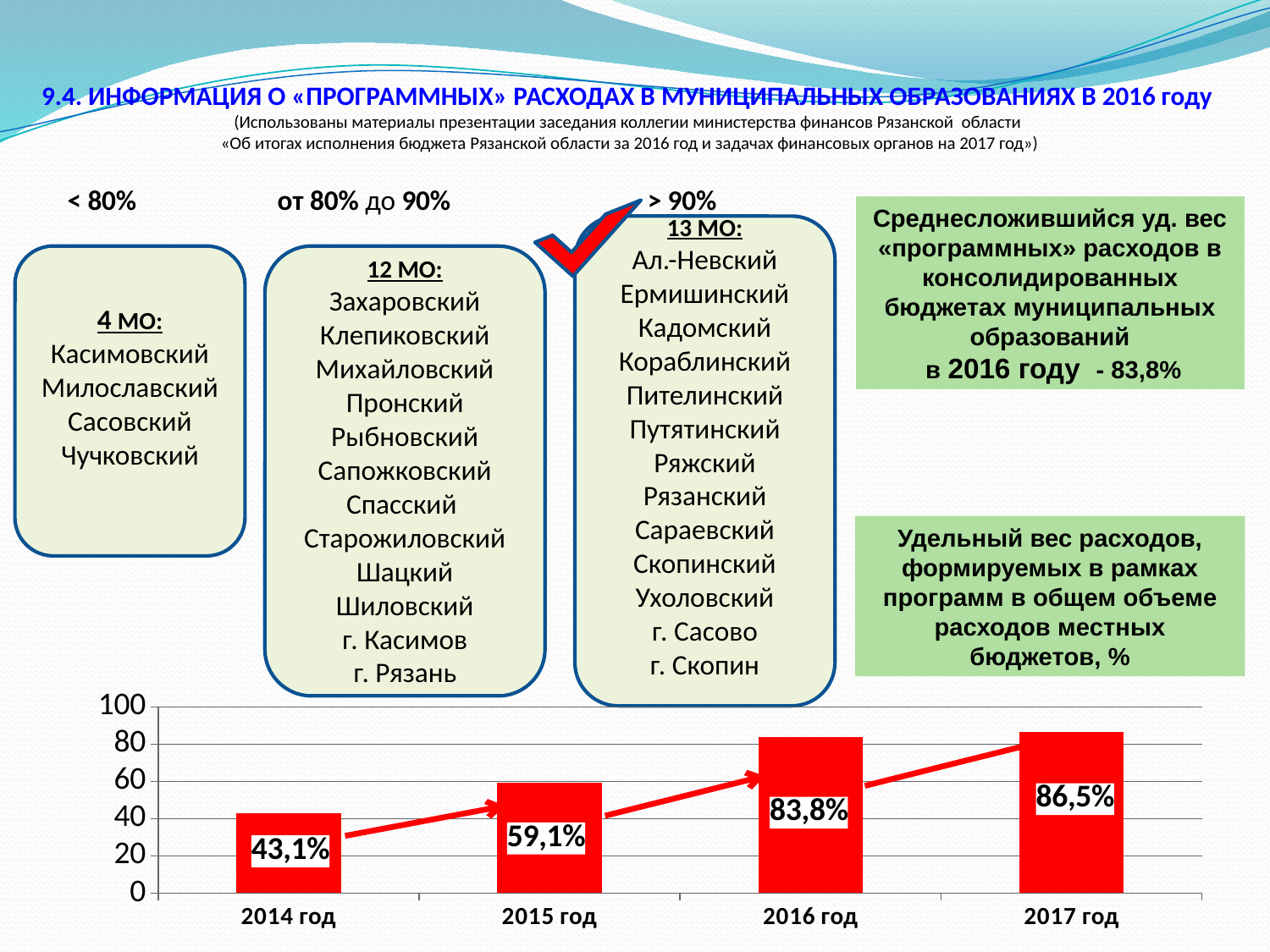
Do the values rise or fall from 2014 год to 2017 год? rise What is the value shown for 2015 год? 59,1% What is the value shown for 2014 год? 43,1% Which year has the highest value in the chart? 2017 год How many years (categories) are shown on the x axis of the chart? 4 What is the difference between the values for 2017 год and 2014 год? 43,4% Which is larger, the value for 2015 год or the value for 2016 год? 2016 год What is the value shown for 2017 год? 86,5% What is the difference between the values for 2016 год and 2015 год? 24,7% Which year has the lowest value in the chart? 2014 год What is the value shown for 2016 год? 83,8% What kind of chart is shown at the bottom of the slide? bar chart